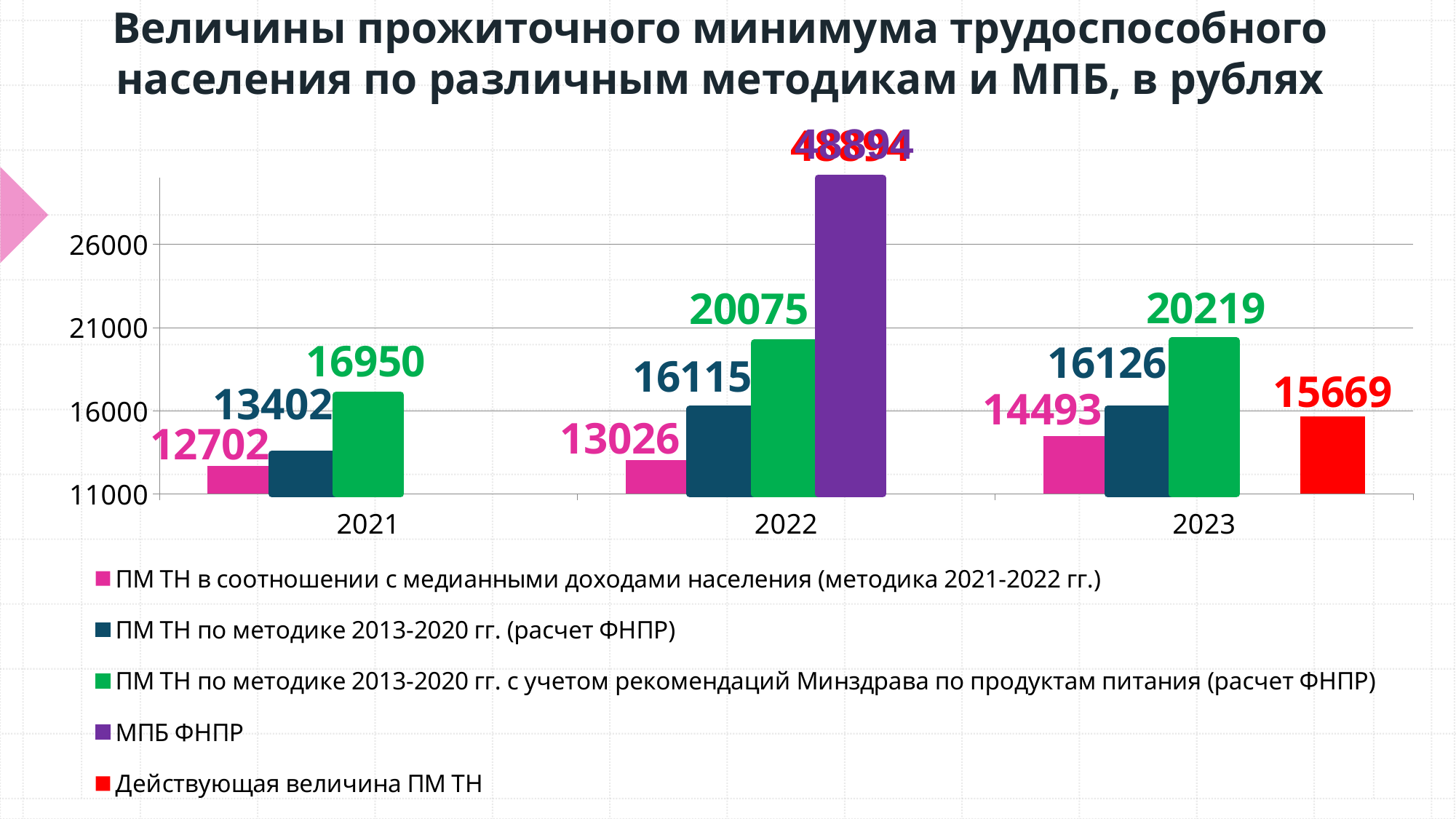
What is the value for ПМ ТН по методике 2013-2020 гг. с учетом рекомендаций Минздрава по продуктам питания in 2023? 20219 What is the value of the МПБ ФНПР bar in 2022? 48894 What is the value of the Действующая величина ПМ ТН bar in 2023? 15669 What is the difference between the green bar and the pink bar in 2022? 7049 What type of chart is shown on the slide? bar chart Which is larger in 2023: the Действующая величина ПМ ТН bar or the ПМ ТН по методике 2013-2020 гг. (расчет ФНПР) bar? ПМ ТН по методике 2013-2020 гг. (расчет ФНПР) What colour is the МПБ ФНПР series in the legend? purple What is the value for ПМ ТН по методике 2013-2020 гг. (расчет ФНПР) in 2021? 13402 How many series does the legend list? 5 How many years are shown on the x axis? 3 Do the values for ПМ ТН по методике 2013-2020 гг. с учетом рекомендаций Минздрава rise or fall from 2021 to 2023? rise Which year has the highest value for ПМ ТН в соотношении с медианными доходами населения? 2023